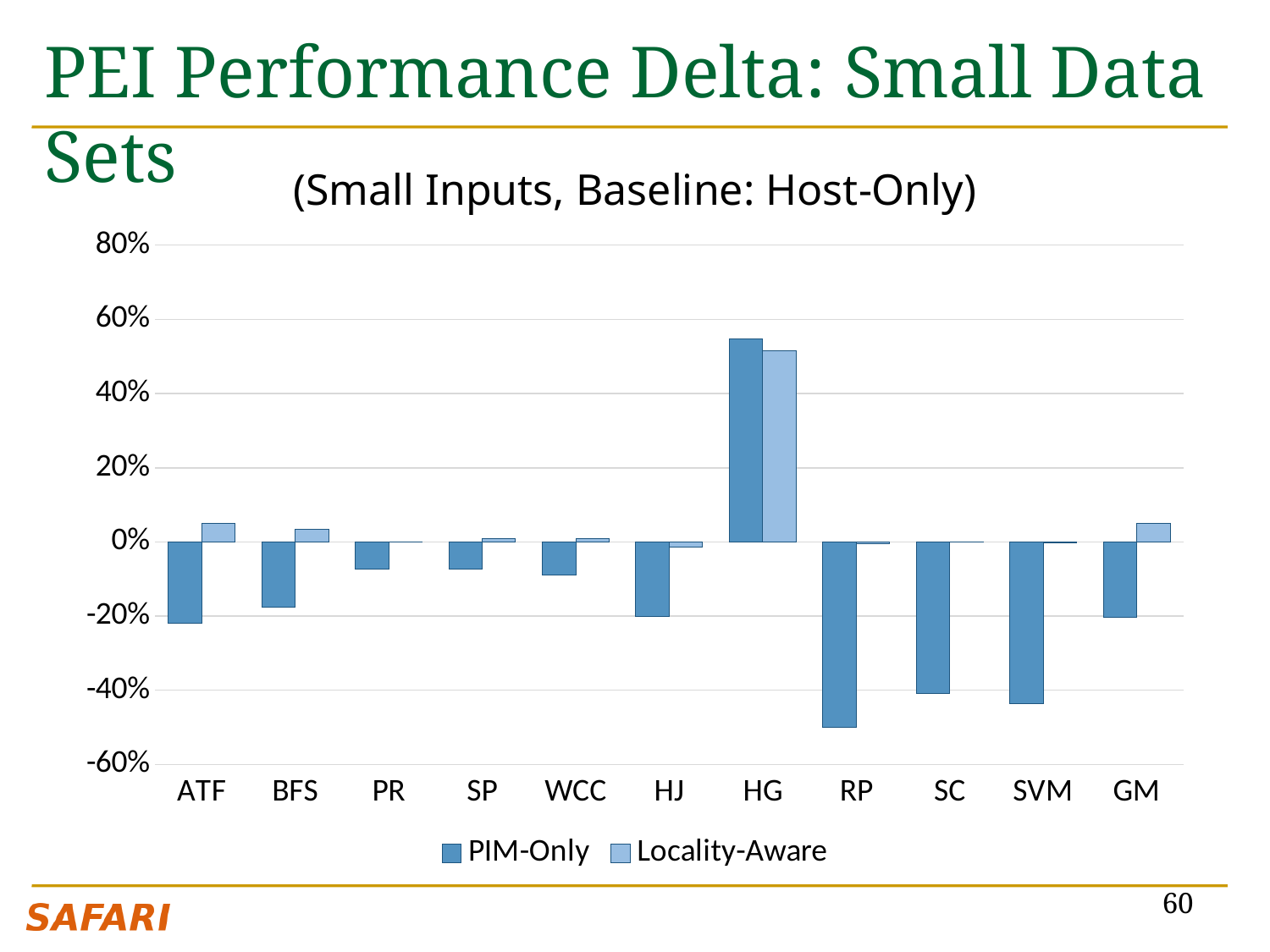
Is the PIM-Only value for SC greater or less than -20%? less What kind of chart is shown on the slide? bar chart Is the PIM-Only value for HG greater or less than 40%? greater Is the PIM-Only value for RP greater or less than -40%? less Which category has the highest PIM-Only value? HG Which is larger for ATF, the PIM-Only value or the Locality-Aware value? Locality-Aware Which category has the highest Locality-Aware value? HG How many categories are shown on the x axis? 11 What are the two series named in the legend? PIM-Only and Locality-Aware How many series does the legend list? 2 Which category has the lowest PIM-Only value? RP Which is larger, the PIM-Only value for RP or the PIM-Only value for SC? SC